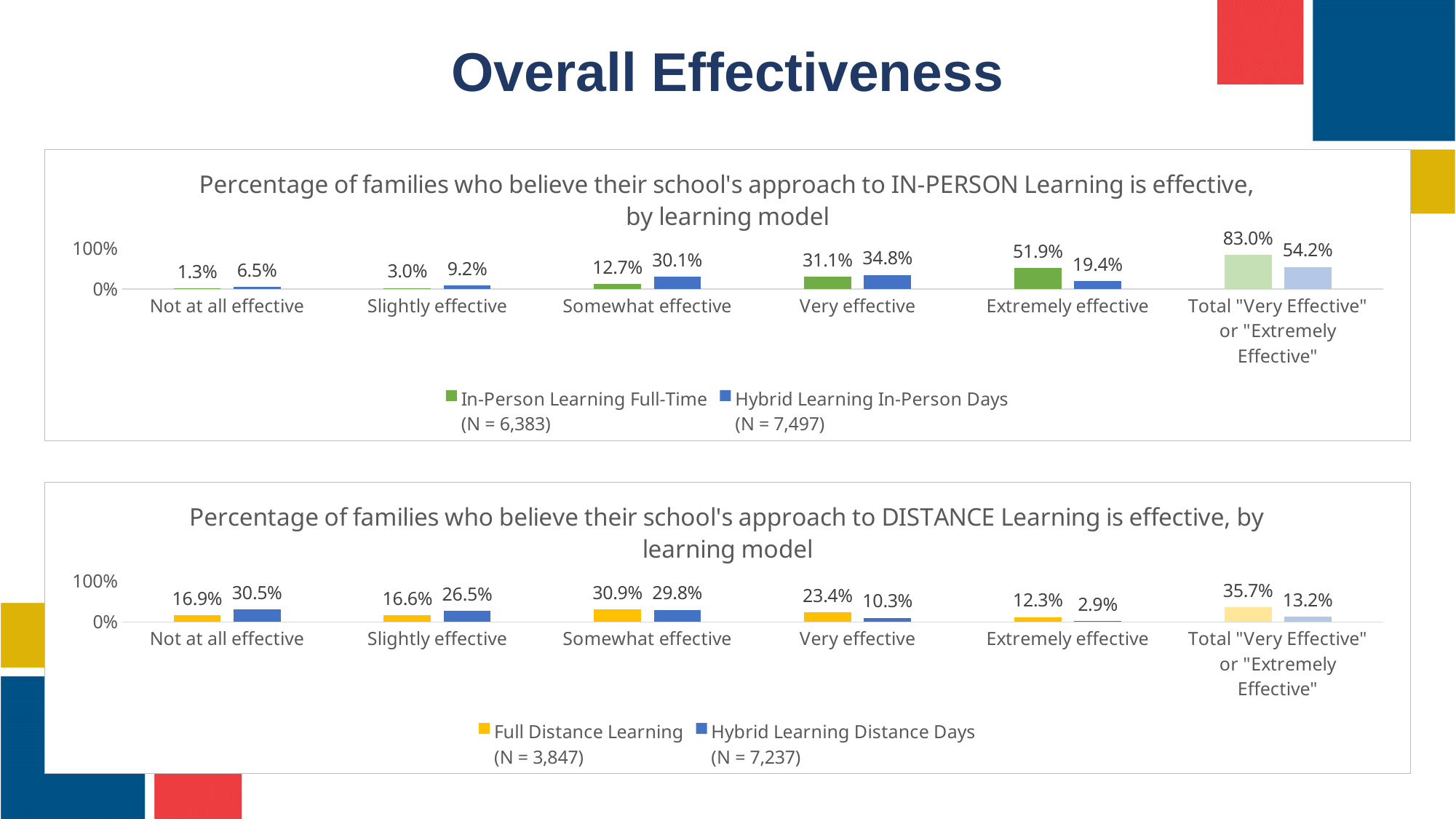
How many categories are shown on the x axis of the IN-PERSON Learning chart? 6 What type of chart is the IN-PERSON Learning chart? Bar chart In the IN-PERSON Learning chart, what is the value for Hybrid Learning In-Person Days in the Somewhat effective category? 30.1% In the IN-PERSON Learning chart, which series has the larger value for Very effective? Hybrid Learning In-Person Days How many series does the legend of the DISTANCE Learning chart list? 2 In the IN-PERSON Learning chart, which category has the highest value for In-Person Learning Full-Time? Total "Very Effective" or "Extremely Effective" In the DISTANCE Learning chart, what percentage of Full Distance Learning families rated their school's approach as Not at all effective? 16.9% In the DISTANCE Learning chart, which category has the lowest value for Hybrid Learning Distance Days? Extremely effective In the IN-PERSON Learning chart, what percentage of In-Person Learning Full-Time families rated their school's approach as Extremely effective? 51.9% In the DISTANCE Learning chart, what is the difference between Full Distance Learning and Hybrid Learning Distance Days in the Very effective category? 13.1% In the IN-PERSON Learning chart, what is the difference between the two series in the Total "Very Effective" or "Extremely Effective" category? 28.8% In the DISTANCE Learning chart, what is the value for Hybrid Learning Distance Days in the Extremely effective category? 2.9%